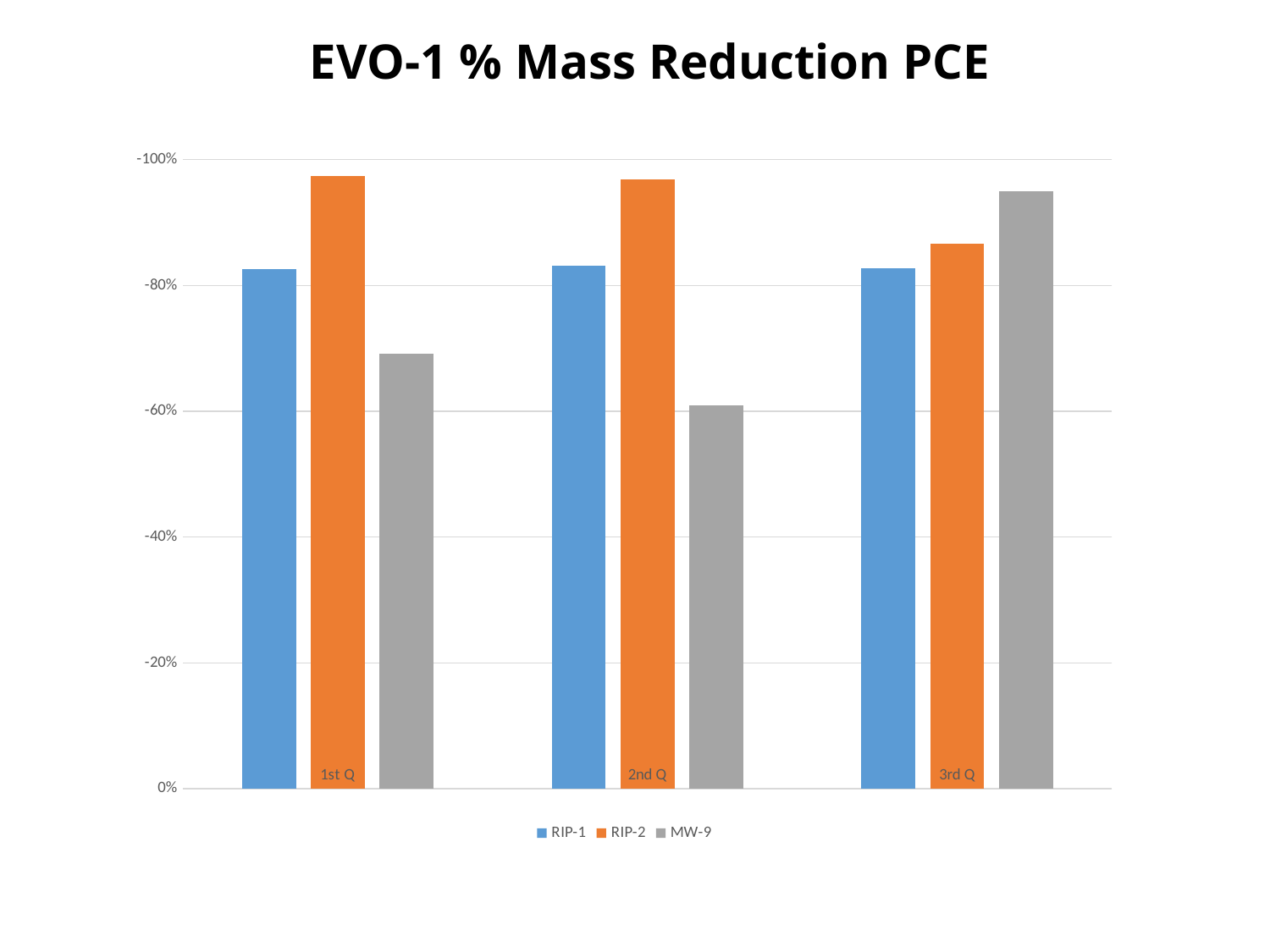
In 3rd Q, which series has the shortest bar (smallest mass reduction)? RIP-1 How many quarter categories are shown on the x axis? 3 Which series is shown in orange in the legend? RIP-2 What kind of chart is shown on the slide? bar chart In 2nd Q, which bar is taller: RIP-2 or MW-9? RIP-2 In 1st Q, which series has the tallest bar (largest mass reduction)? RIP-2 In 3rd Q, which series has the tallest bar (largest mass reduction)? MW-9 In 2nd Q, which series has the shortest bar (smallest mass reduction)? MW-9 What is the title of the chart? EVO-1 % Mass Reduction PCE How many series does the legend list? 3 Is the mass reduction for RIP-2 in 1st Q greater or less than 80% in magnitude? greater Is the mass reduction for MW-9 in 1st Q greater or less than 80% in magnitude? less